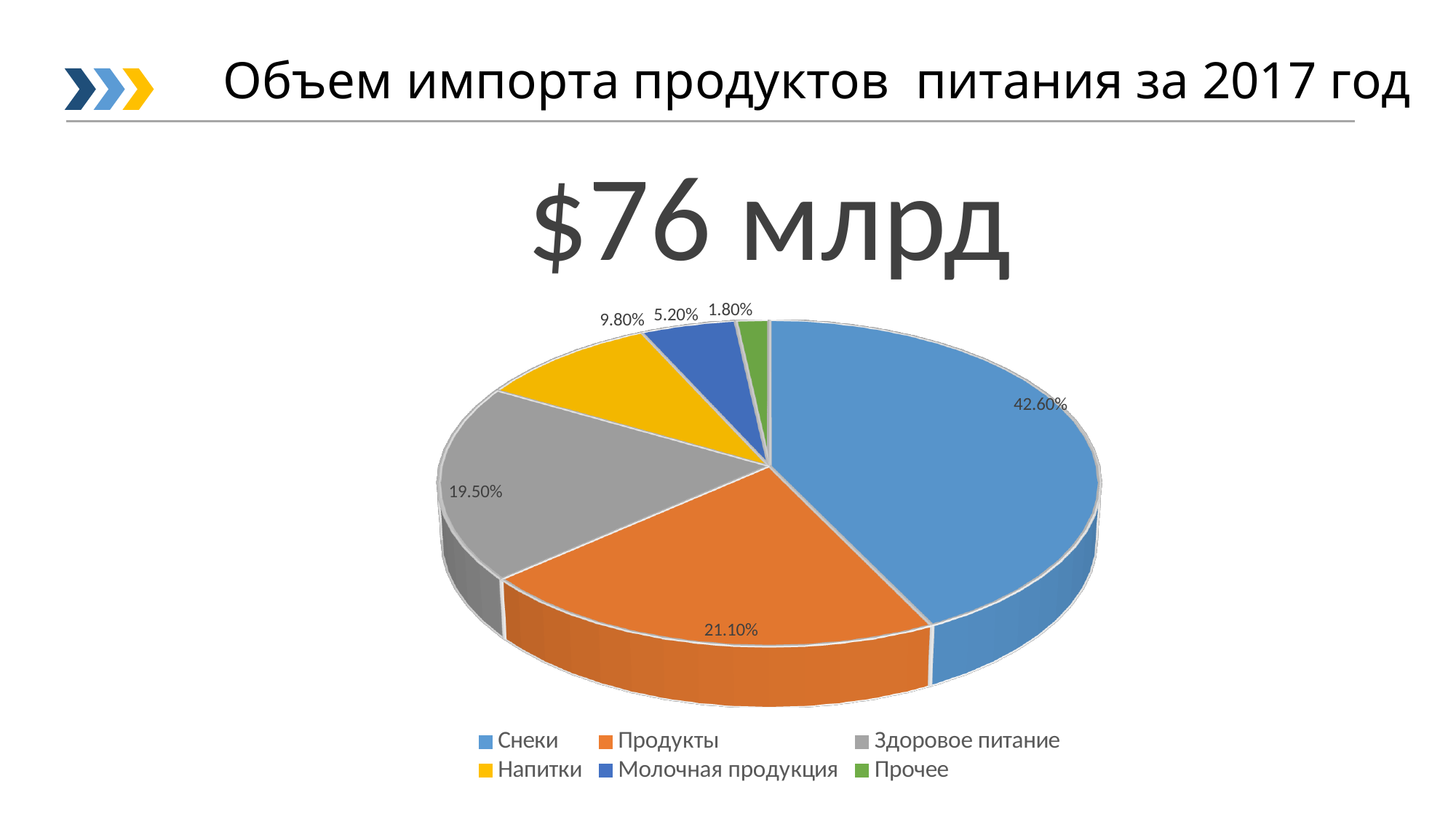
What share of the pie does Молочная продукция have? 5.20% Which category has the largest slice of the pie? Снеки What is the chart title shown above the pie? $76 млрд Which category has the smallest slice of the pie? Прочее What share of the pie does Продукты have? 21.10% What share of the pie does Здоровое питание have? 19.50% How many categories does the pie chart have? 6 Which is larger, the share of Напитки or the share of Молочная продукция? Напитки What colour is the slice for Прочее? Green What is the difference between the shares of Снеки and Продукты? 21.50% What share of the pie does Снеки have? 42.60% What type of chart is shown on the slide? Pie chart